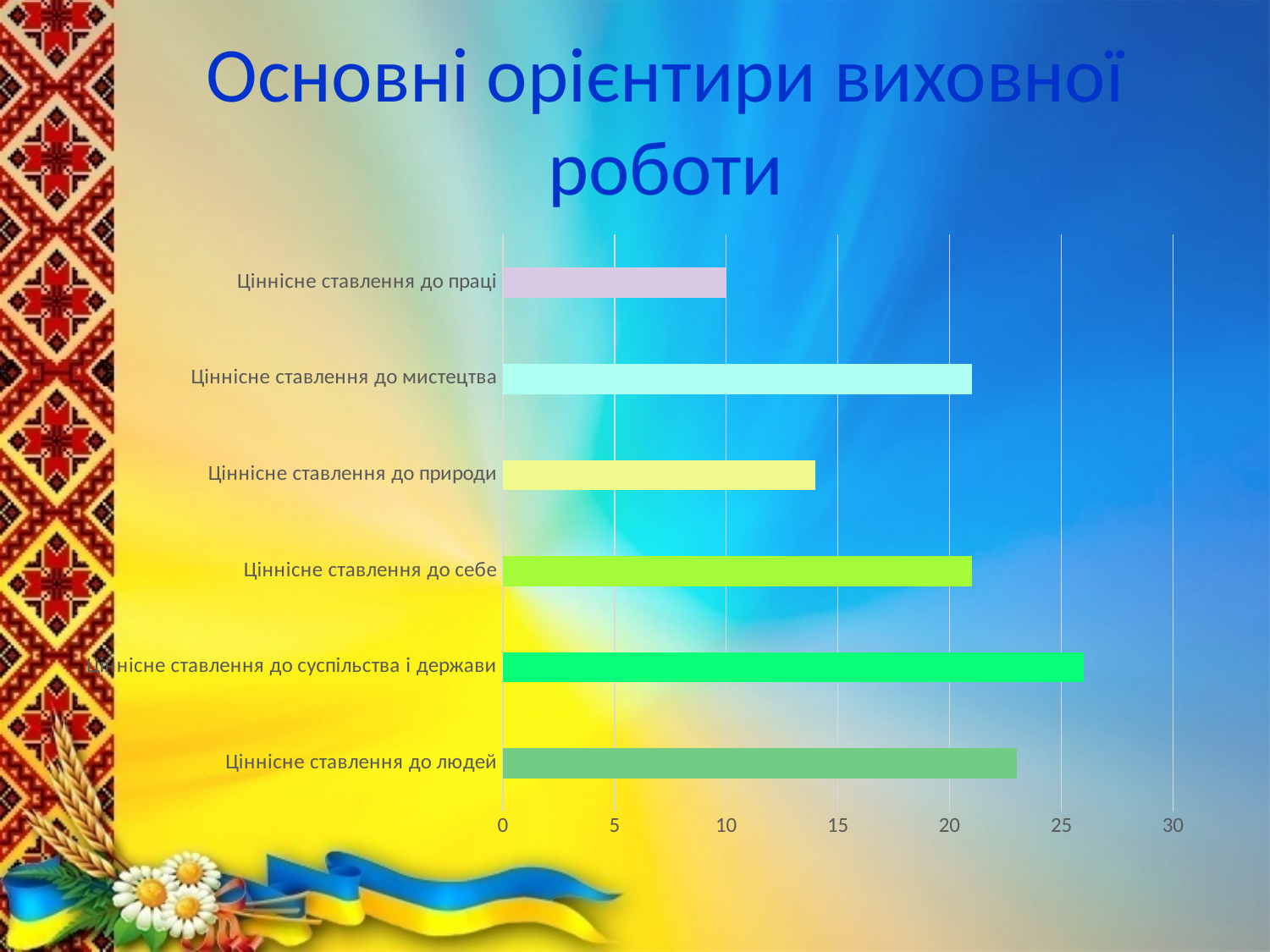
How many categories are plotted in the chart? 6 Is the value for "Ціннісне ставлення до суспільства і держави" greater or less than 25? greater Is the value for "Ціннісне ставлення до природи" greater or less than 15? less What is the title of the slide containing the chart? Основні орієнтири виховної роботи Is the value for "Ціннісне ставлення до мистецтва" greater or less than 25? less What kind of chart is shown on the slide? bar chart Which category has the lowest value in the chart? Ціннісне ставлення до праці Which category has the highest value in the chart? Ціннісне ставлення до суспільства і держави Which is larger: the value for "Ціннісне ставлення до людей" or for "Ціннісне ставлення до природи"? Ціннісне ставлення до людей Which is larger: the value for "Ціннісне ставлення до природи" or for "Ціннісне ставлення до праці"? Ціннісне ставлення до природи What is the value for "Ціннісне ставлення до праці"? 10